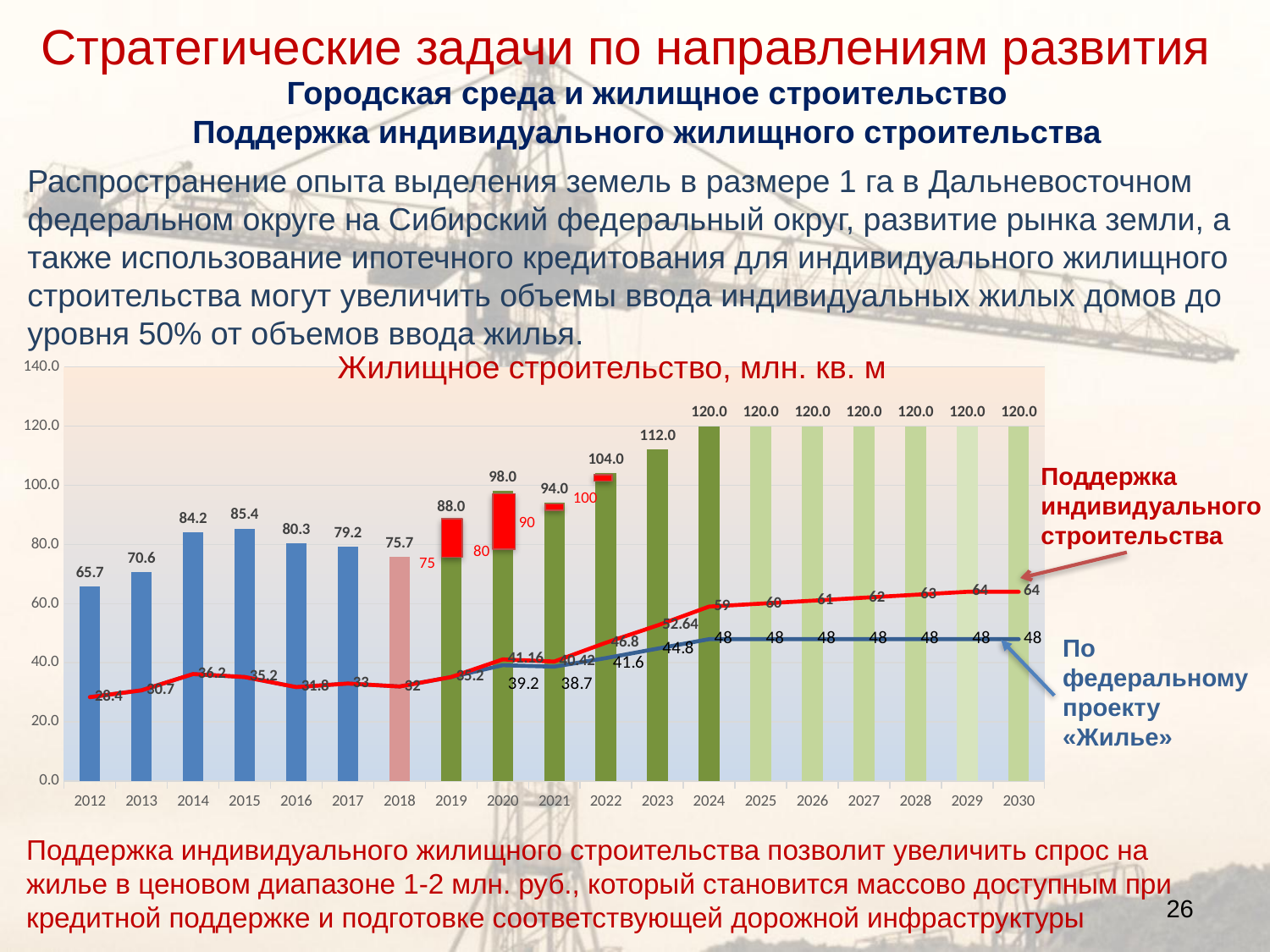
What is the highest bar value shown on the chart? 120.0 What is the bar value for 2012? 65.7 What is the bar value for 2030? 120.0 Is the bar value for 2022 greater or less than 100.0? greater What is the title of the chart? Жилищное строительство, млн. кв. м What is the bar value for 2018? 75.7 What is the bar value for 2023? 112.0 How many years are shown on the x axis? 19 What is the difference between the bar values for 2015 and 2014? 1.2 Which bar is taller, 2020 or 2021? 2020 Which year has the lowest bar value? 2012 What kind of chart is shown on the slide? Bar chart with line series